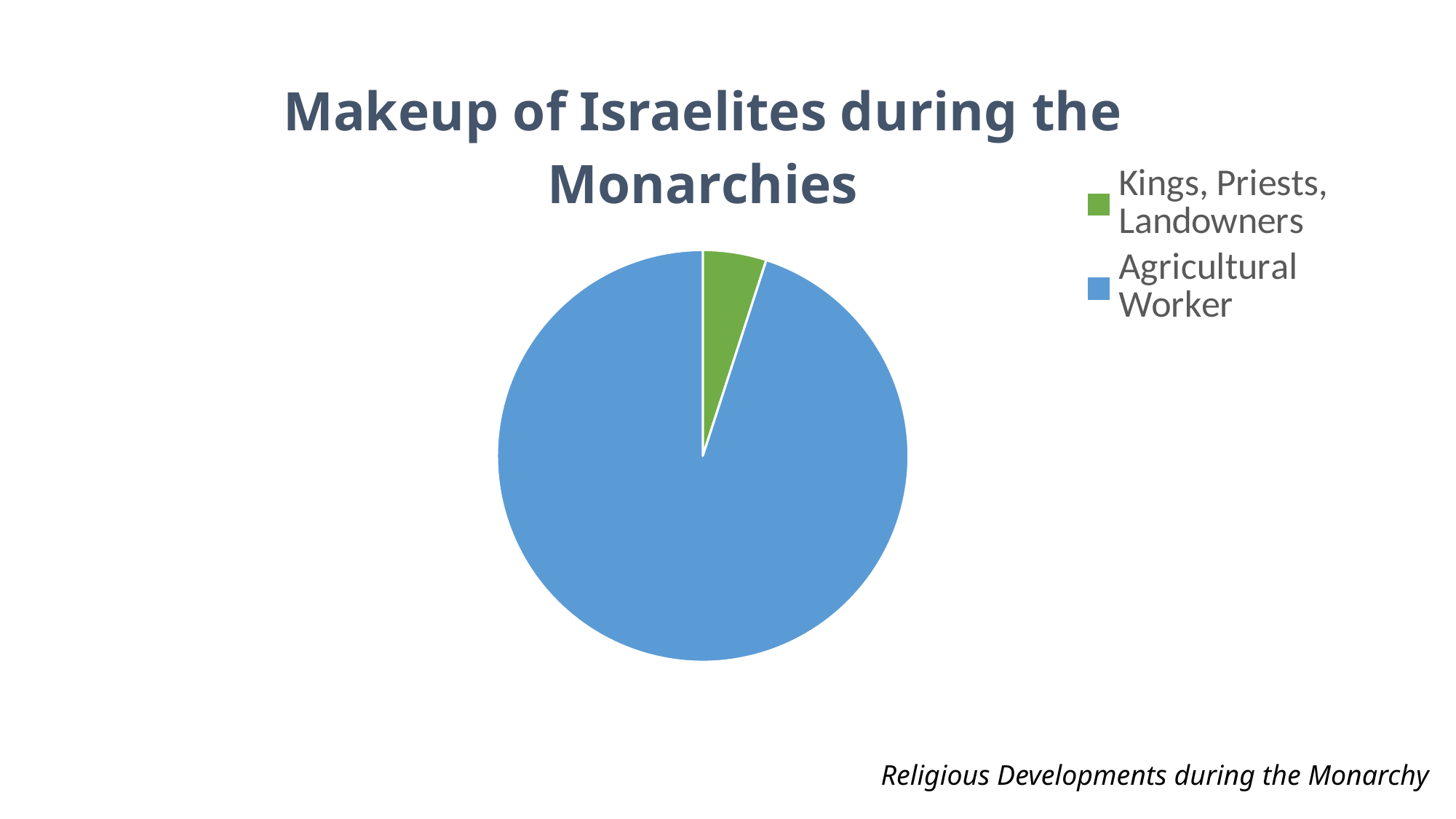
Which category has the smallest slice of the pie? Kings, Priests, Landowners What is the title of the chart? Makeup of Israelites during the Monarchies What kind of chart is shown on the slide? pie chart Which slice is larger, Agricultural Worker or Kings, Priests, Landowners? Agricultural Worker What colour is the slice for Kings, Priests, Landowners? green Which category has the largest slice of the pie? Agricultural Worker How many categories does the pie chart show? 2 How many entries does the legend list? 2